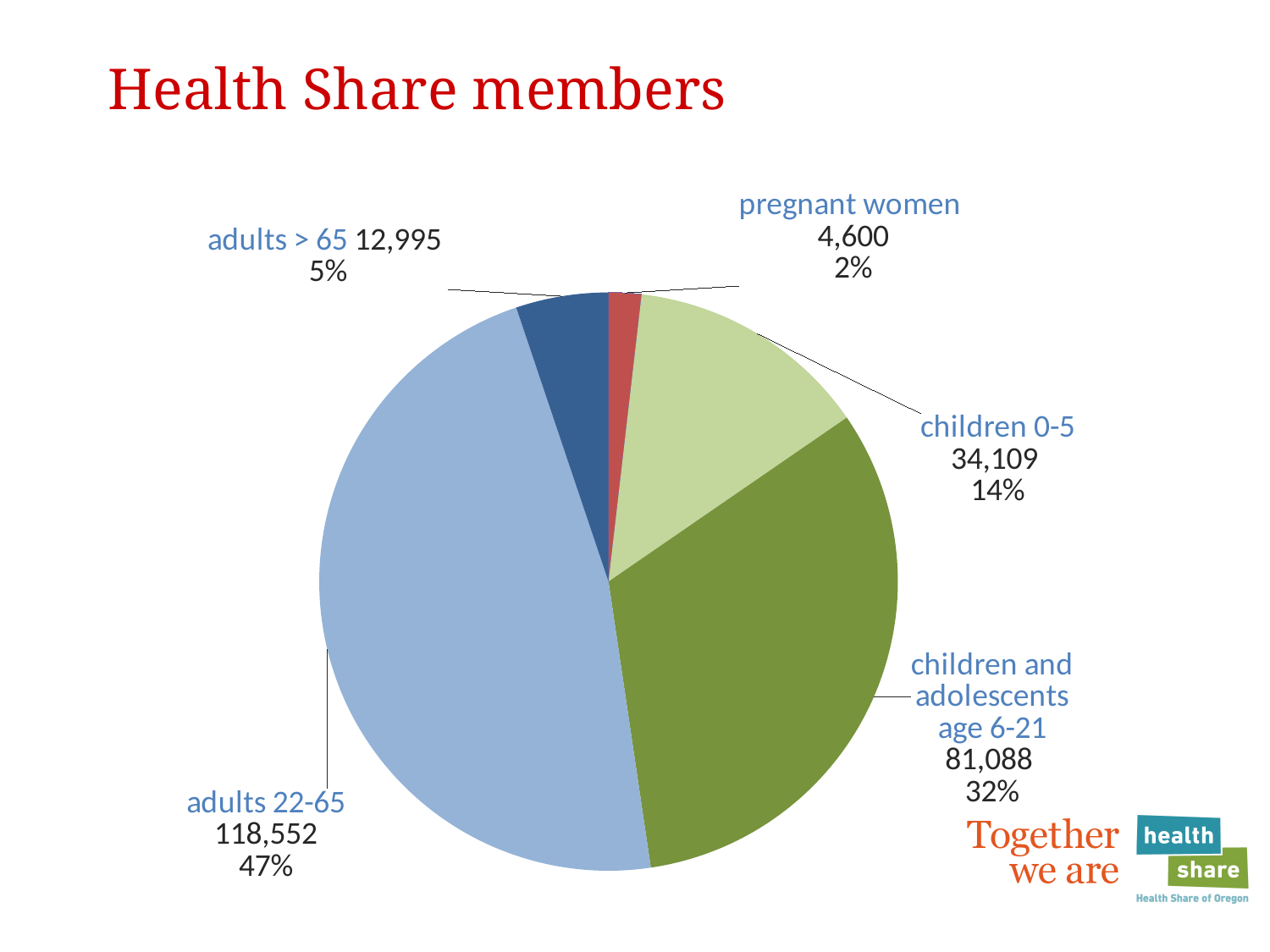
Which category has the largest number of members? adults 22-65 Which has more members, children 0-5 or adults > 65? children 0-5 How many members are pregnant women? 4,600 What kind of chart is shown on the slide? pie chart What share of members are children and adolescents age 6-21? 32% What is the title of the slide containing the pie chart? Health Share members How many slices does the pie chart have? 5 What share of members are adults > 65? 5% What is the difference in members between adults 22-65 and children and adolescents age 6-21? 37,464 Which category has the smallest number of members? pregnant women How many Health Share members are adults 22-65? 118,552 How many members are children 0-5? 34,109